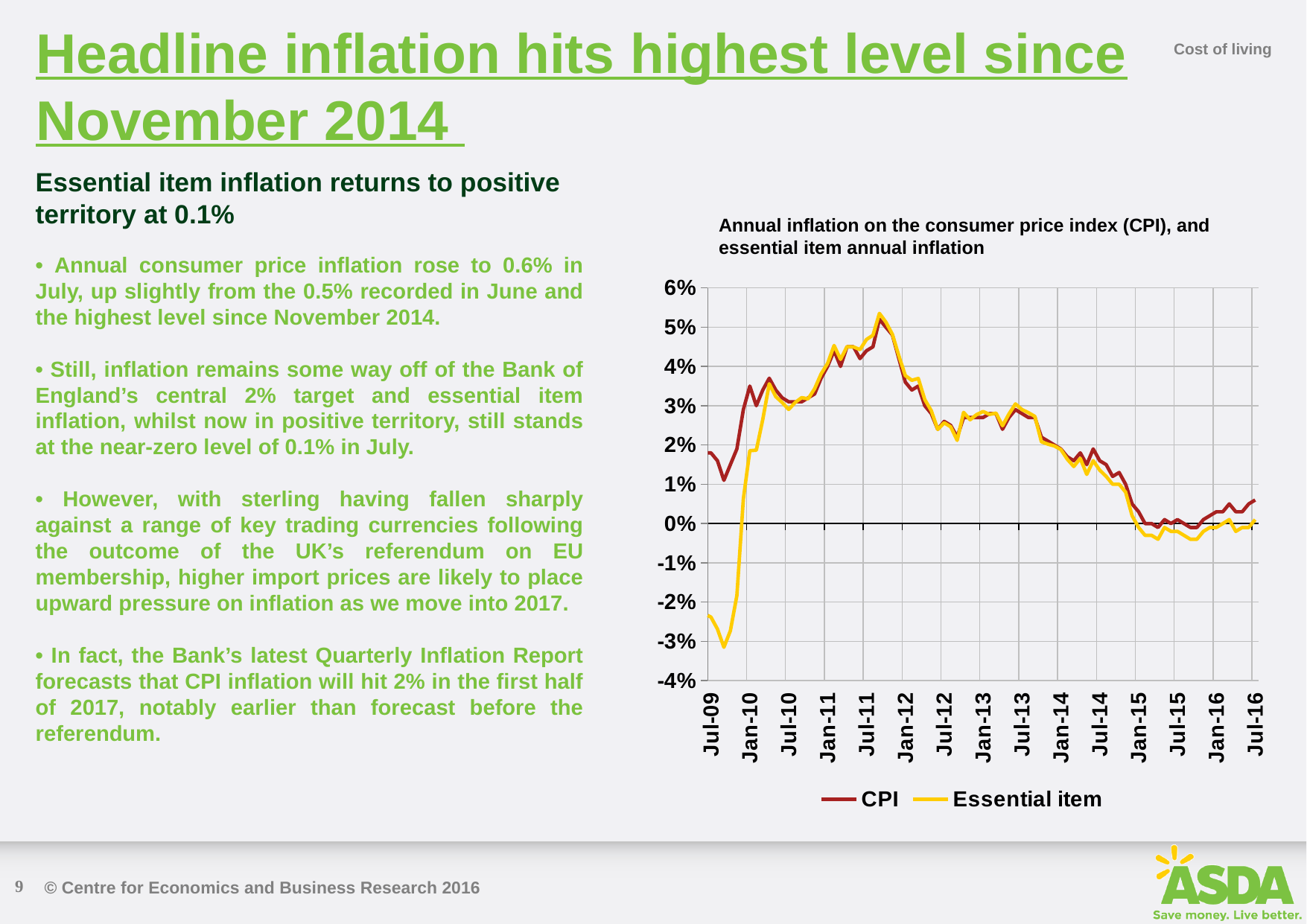
How many date labels are shown along the x axis of the chart? 15 Is the CPI value at Jul-11 greater or less than 4%? greater Does the CPI line rise or fall between Jul-11 and Jan-15? Fall How many series does the chart's legend list? 2 Is the CPI value at Jan-14 greater or less than 1%? greater What are the two series named in the chart's legend? CPI and Essential item Is the CPI value at Jul-09 greater or less than 1%? greater What kind of chart is shown on the slide? Line chart Does the Essential item line rise or fall between Jul-09 and Jan-10? Rise What colour is the Essential item line in the chart? Yellow At Jan-10, which series has the higher value, CPI or Essential item? CPI